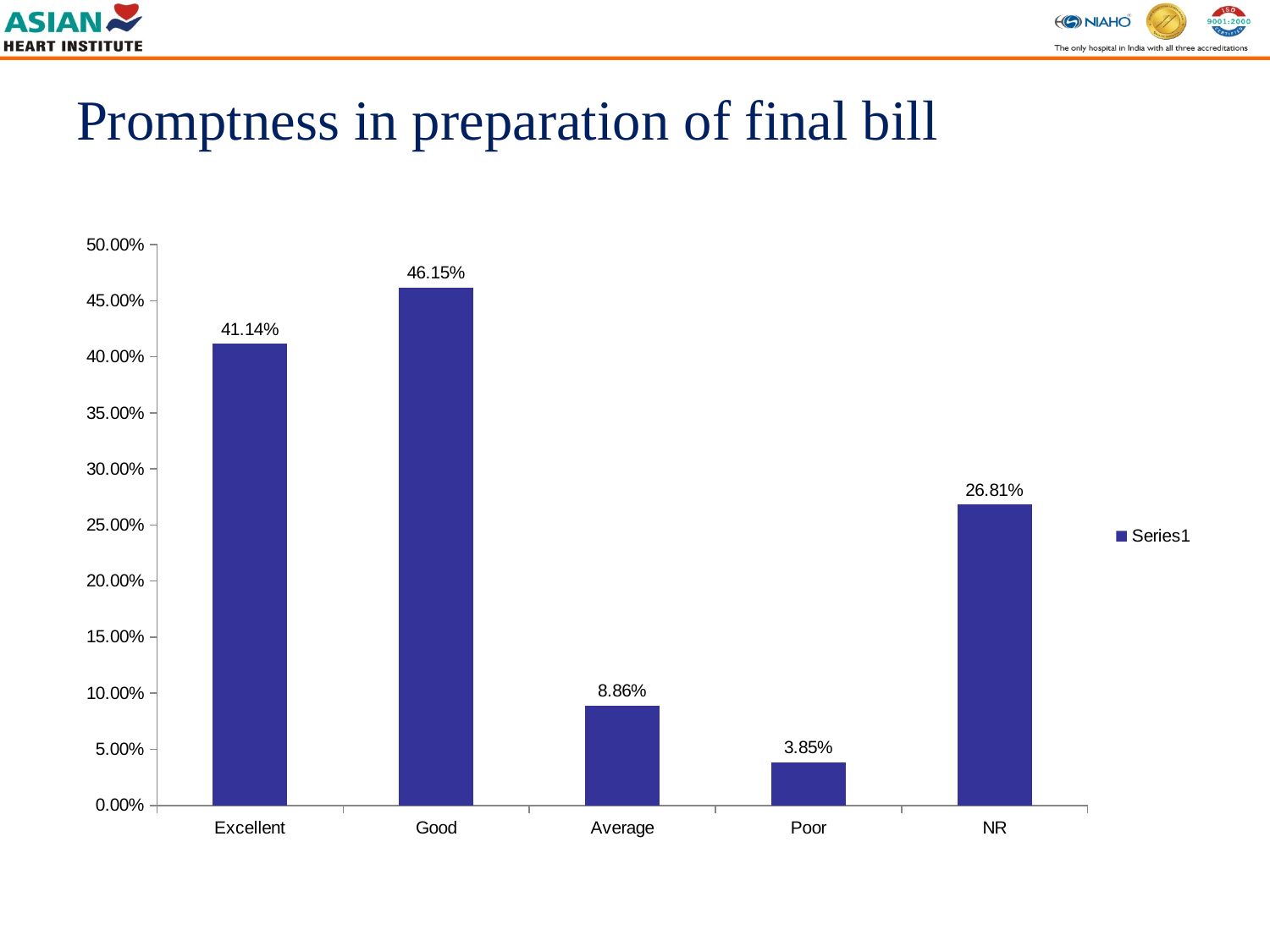
What is the value for NR? 26.81% What is the value for Poor? 3.85% What kind of chart is shown on the slide? bar chart What is the name of the series listed in the legend? Series1 Is the value for Average greater or less than 10.00%? less What is the difference between the values for Good and Excellent? 5.01% How many categories are shown on the x axis? 5 What is the value for Good? 46.15% Which is larger, the value for Excellent or the value for NR? Excellent Which category has the highest value? Good What is the difference between the values for Average and Poor? 5.01% Which category has the lowest value? Poor